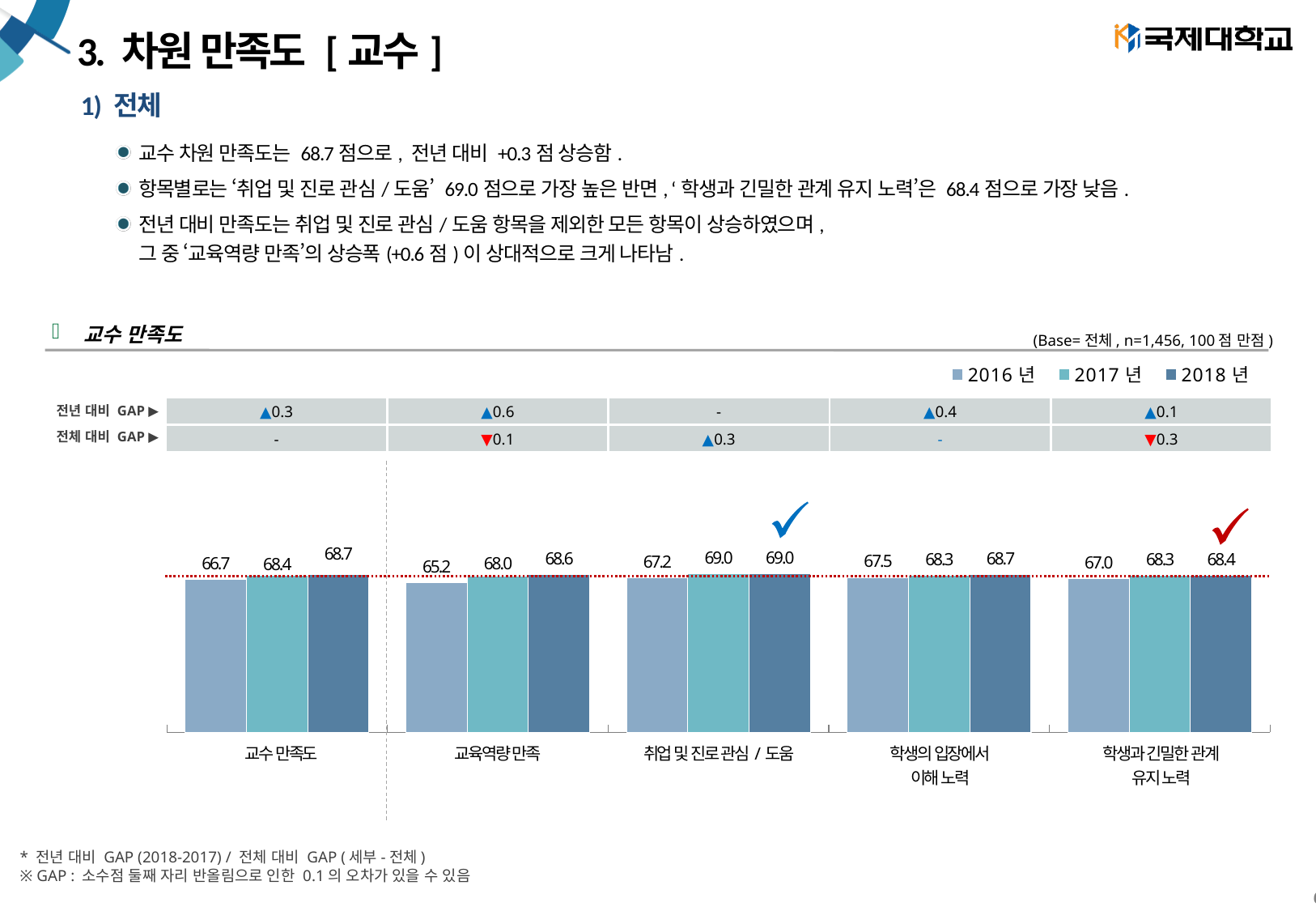
How many categories are shown on the x axis of the chart? 5 What is the 2018년 value for 교수 만족도? 68.7 What is the 2016년 value for 교육역량 만족? 65.2 Which category has the highest 2018년 value? 취업 및 진로 관심 / 도움 What is the 2018년 value for 학생과 긴밀한 관계 유지 노력? 68.4 How many series does the legend list? 3 Do the values for 교수 만족도 rise or fall from 2016년 to 2018년? Rise Which is larger for 학생의 입장에서 이해 노력: the 2017년 value or the 2018년 value? 2018년 What is the 2017년 value for 취업 및 진로 관심 / 도움? 69.0 What is the difference between the 2018년 and 2016년 values for 교육역량 만족? 3.4 Which category has the lowest 2016년 value? 교육역량 만족 What kind of chart is shown on the slide? Bar chart